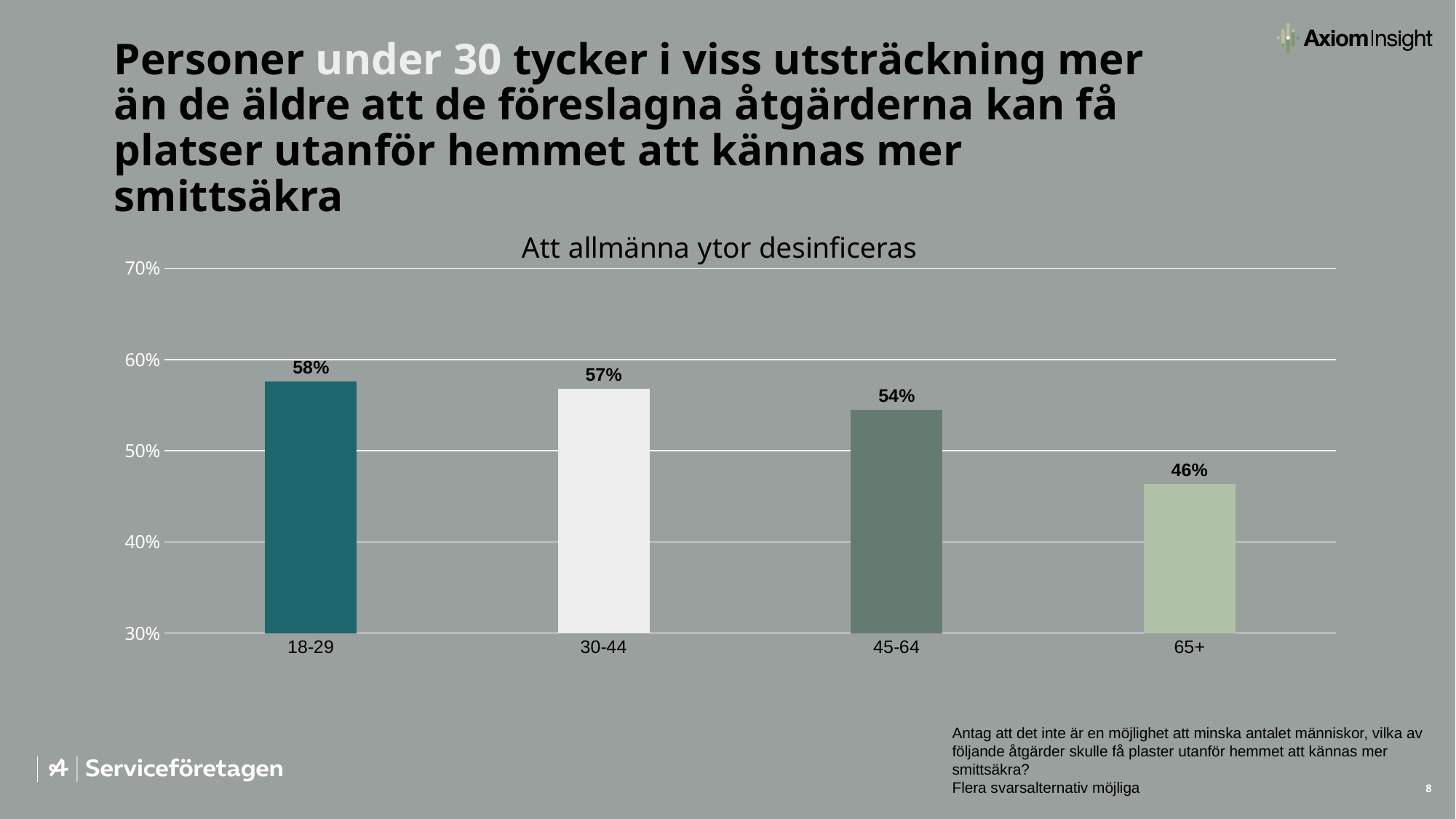
What kind of chart is shown on the slide? bar chart What is the value for the 18-29 age group? 58% Which is larger, the value for 45-64 or the value for 65+? 45-64 What is the difference between the values for 18-29 and 65+? 12 percentage points What is the title of the chart? Att allmänna ytor desinficeras What is the value for the 45-64 age group? 54% What is the value for the 65+ age group? 46% How many age groups are shown in the chart? 4 Is the value for 65+ greater or less than 50%? less Which age group has the highest value? 18-29 What is the value for the 30-44 age group? 57% Which age group has the lowest value? 65+